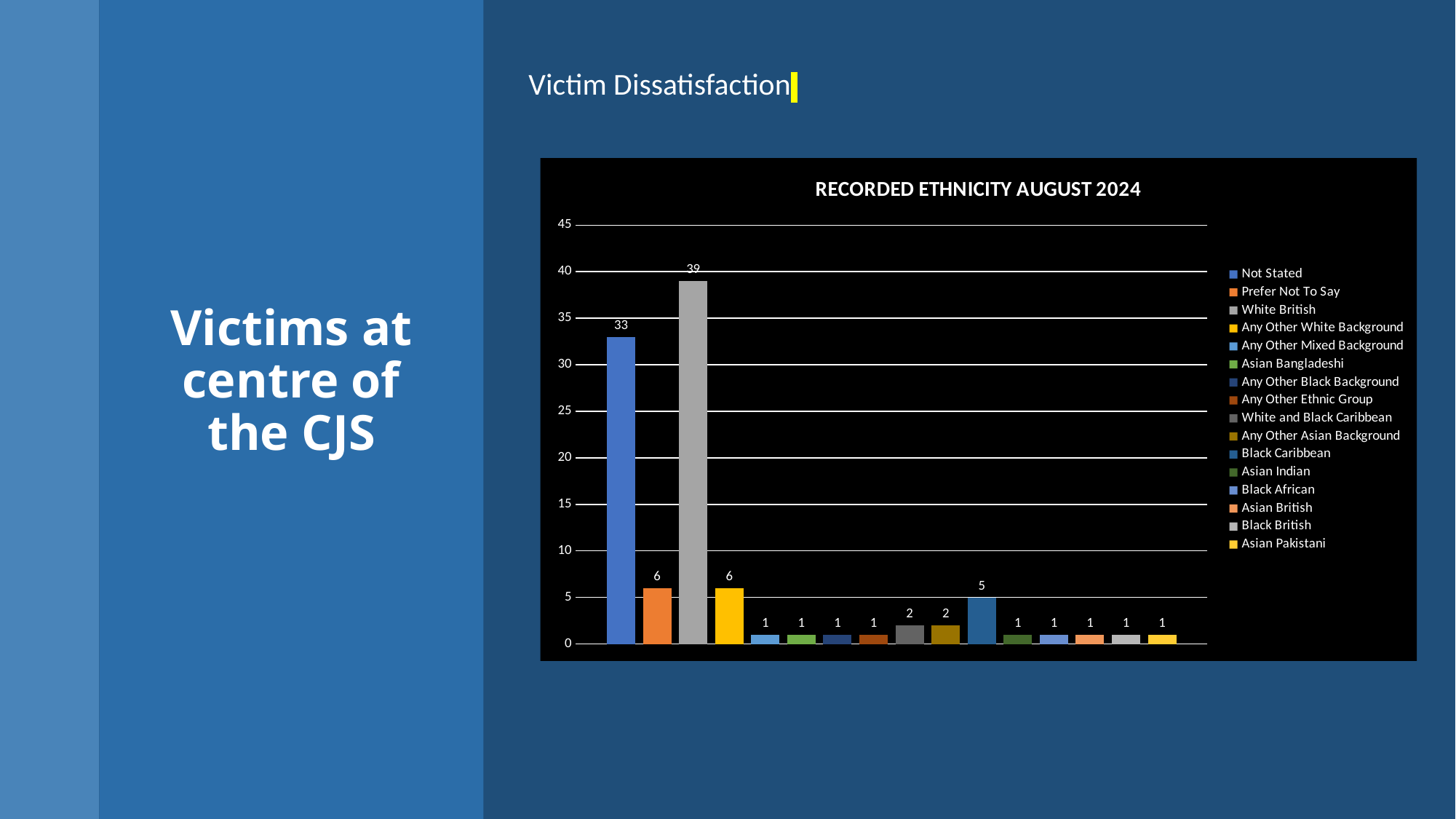
What is the difference between the values for White British and Not Stated? 6 What is the value for White British? 39 What is the title of the chart? RECORDED ETHNICITY AUGUST 2024 What is the value for Black Caribbean? 5 Which is larger, the value for Not Stated or the value for White British? White British How many bars are plotted in the chart? 16 What is the value for Not Stated? 33 Which category has the highest value? White British What is the value for Prefer Not To Say? 6 How many entries does the legend list? 16 What is the difference between the values for Prefer Not To Say and Black Caribbean? 1 Is the value for Not Stated greater or less than 30? greater